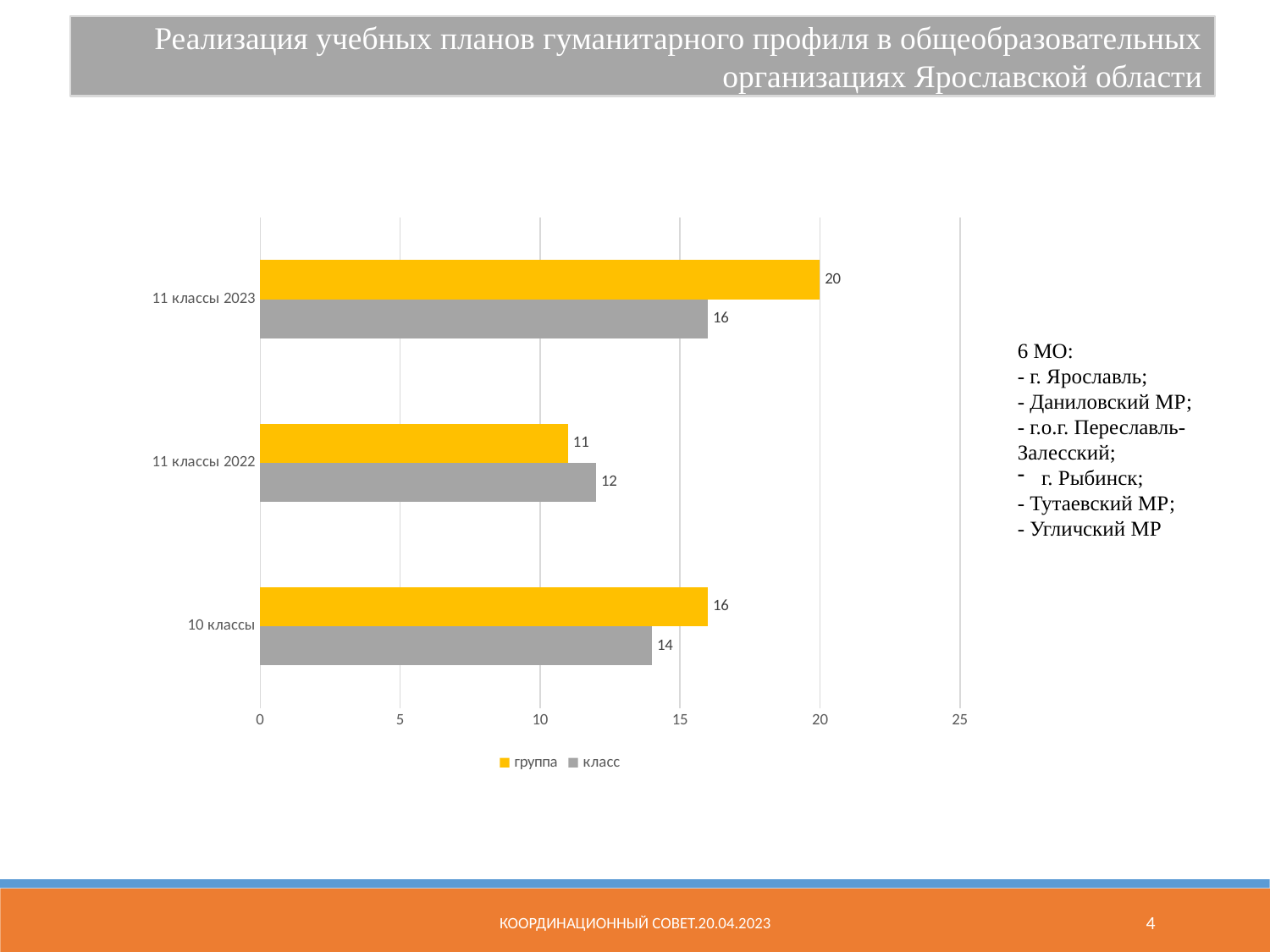
How many categories are shown on the chart? 3 What is the value for "группа" in the "11 классы 2023" category? 20 What is the value for "класс" in the "11 классы 2022" category? 12 Is the value for "группа" in "10 классы" greater or less than 15? greater Which category has the highest value for the "группа" series? 11 классы 2023 How many series does the legend list? 2 What kind of chart is shown on the slide? bar chart What is the value for "класс" in the "10 классы" category? 14 For "11 классы 2022", which is larger: "группа" or "класс"? класс Which category has the lowest value for the "класс" series? 11 классы 2022 What is the difference between the "группа" and "класс" values for "11 классы 2023"? 4 What colour are the bars for the "группа" series? yellow